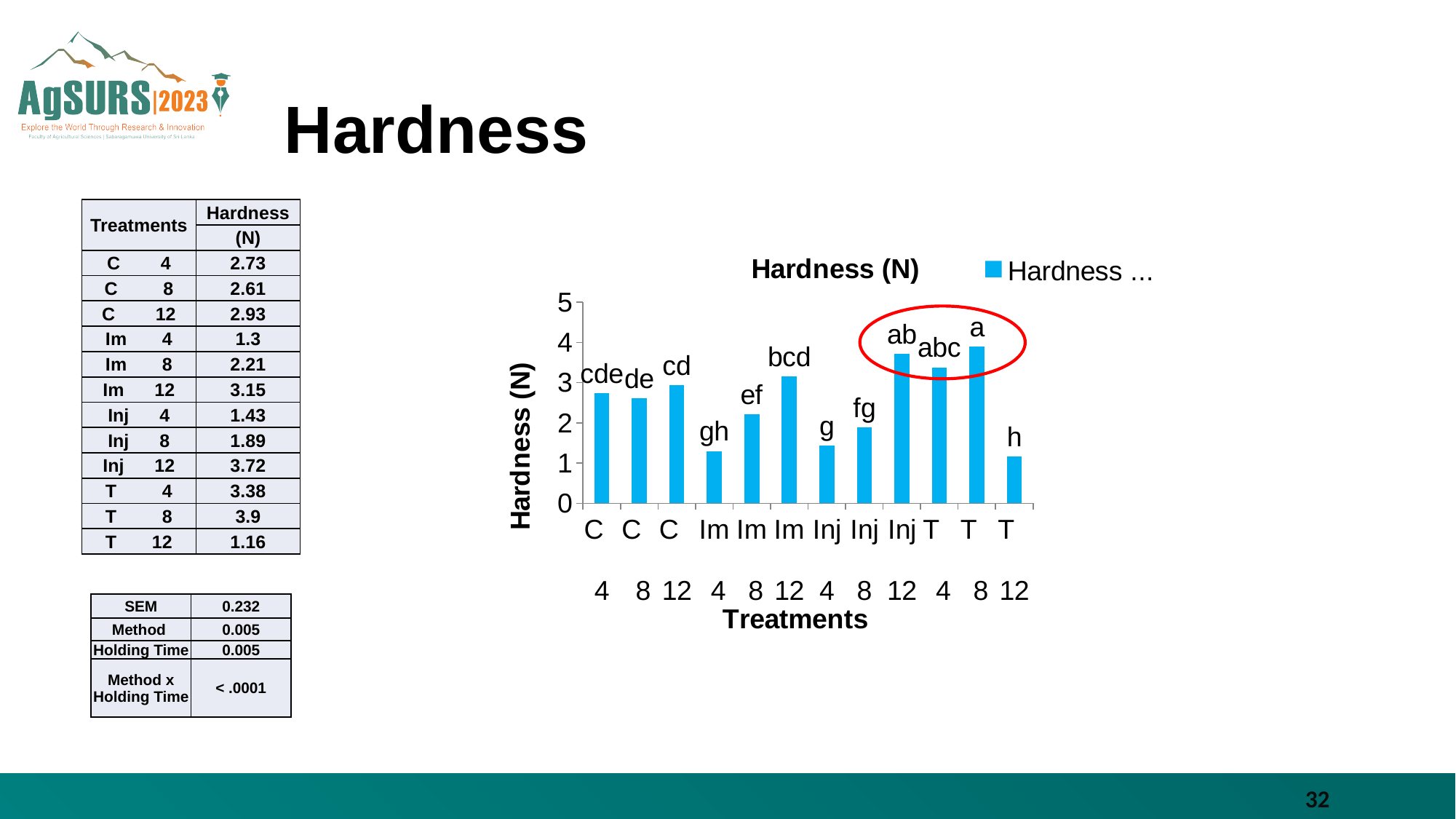
What type of chart is shown on the slide? bar chart What letter label is printed above the bar for T 8? a What is the title of the x axis of the chart? Treatments What is the title of the chart? Hardness (N) Which bar is taller, Inj 12 or Inj 4? Inj 12 Is the value for Inj 12 greater or less than 3? greater How many bars are plotted in the Hardness (N) chart? 12 How many series does the legend of the chart list? 1 Is the value for T 12 greater or less than 2? less Which treatment has the tallest bar in the chart? T 8 Is the value for C 4 greater or less than 2? greater